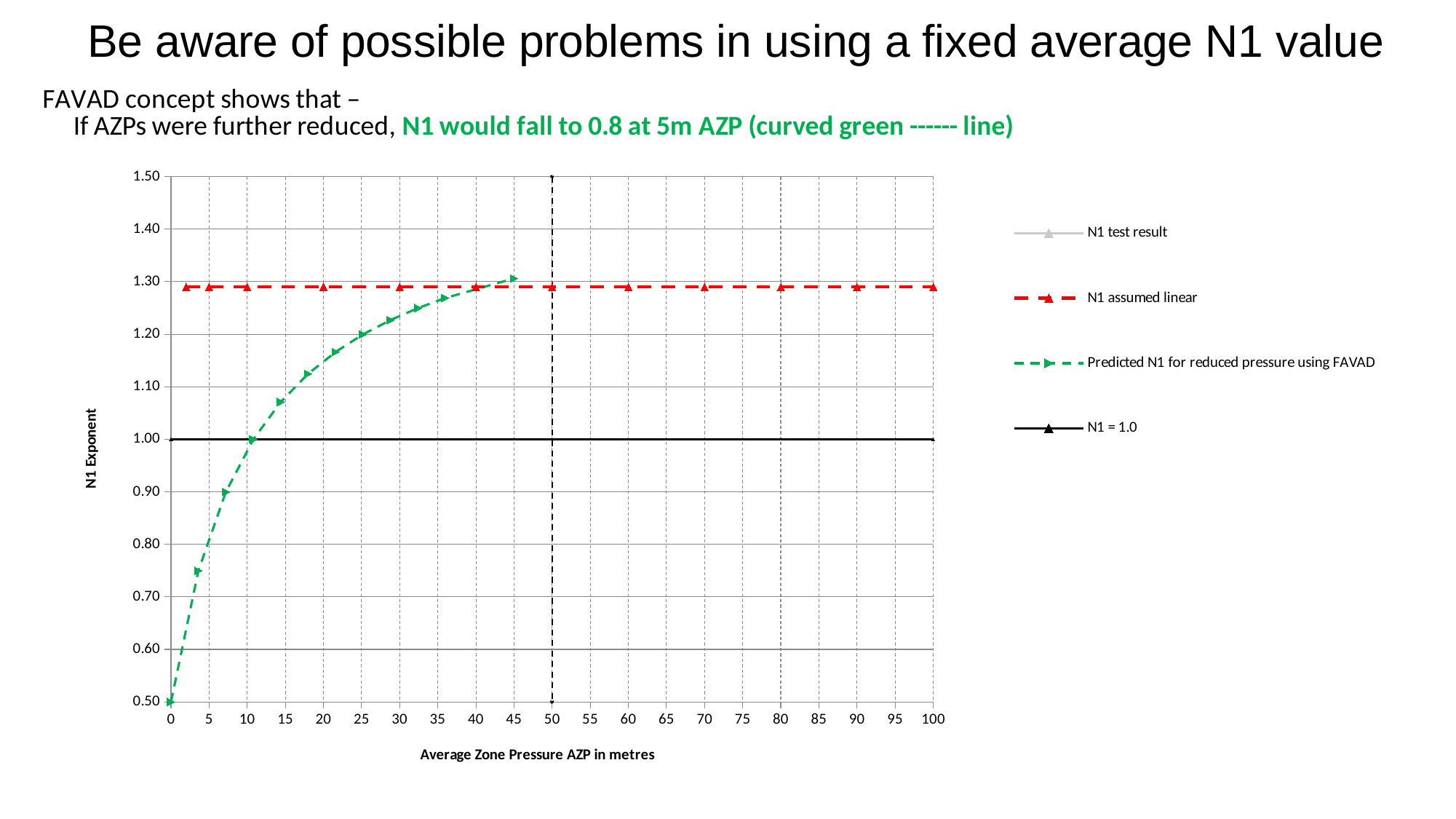
Does the 'Predicted N1 for reduced pressure using FAVAD' series rise or fall as AZP increases from 0 to 45 metres? rise What kind of chart is shown on the slide? line chart Is the value of the 'N1 assumed linear' series at an AZP of 60 metres greater or less than 1.20? greater Is the value of the 'N1 assumed linear' series at an AZP of 80 metres greater or less than 1.30? less What is the value of the 'N1 = 1.0' series at an AZP of 60 metres? 1.00 What is the value of the 'Predicted N1 for reduced pressure using FAVAD' series at an AZP of 0 metres? 0.50 Is the value of the 'Predicted N1 for reduced pressure using FAVAD' series at an AZP of 20 metres greater or less than 1.10? greater What is the title of the chart's x axis? Average Zone Pressure AZP in metres What is the title of the chart's y axis? N1 Exponent How many series does the chart legend list? 4 At an AZP of 20 metres, which series has the higher value: 'N1 assumed linear' or 'Predicted N1 for reduced pressure using FAVAD'? N1 assumed linear